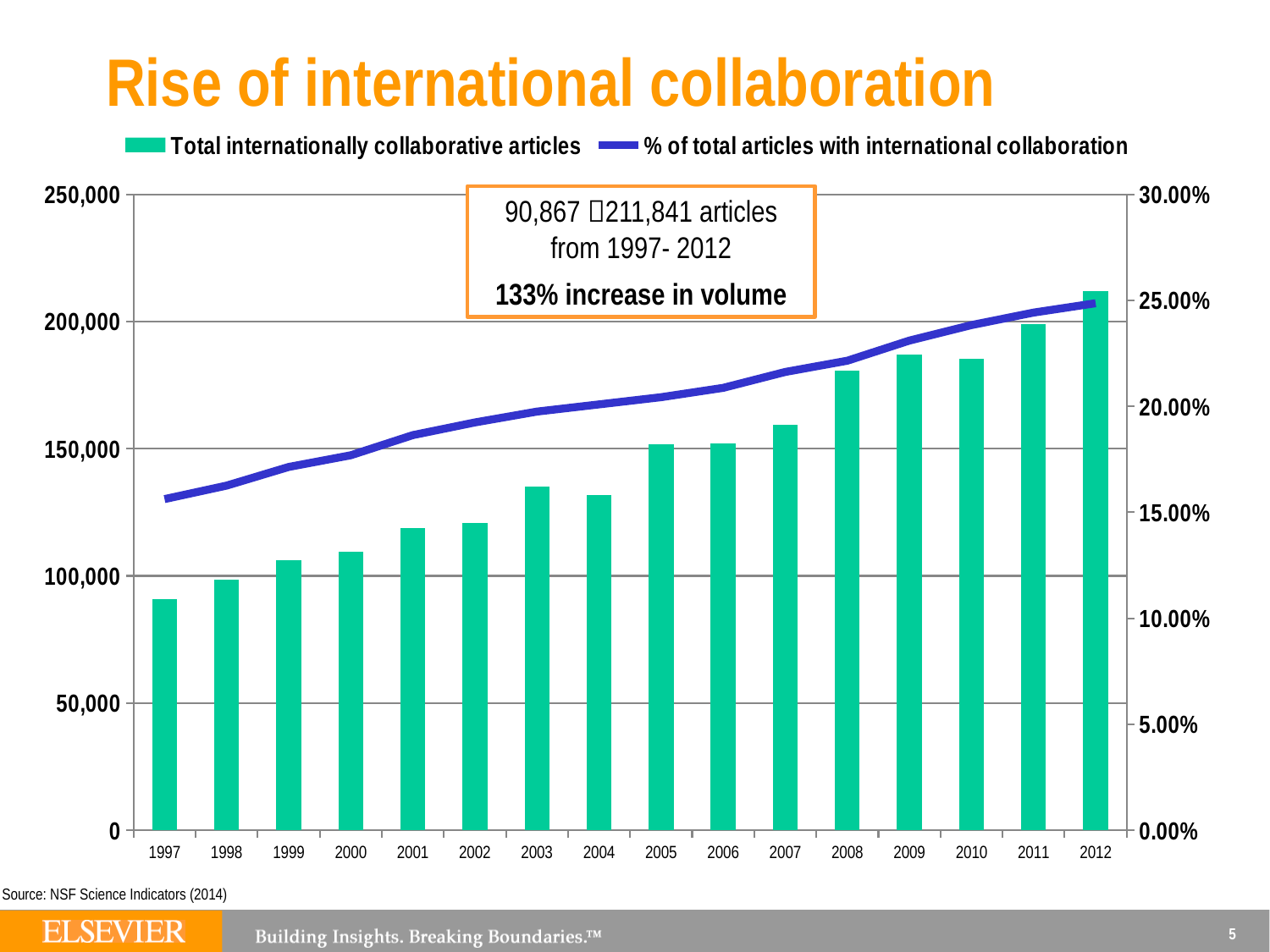
Is the number of internationally collaborative articles in 2004 greater or less than 150,000? less Which year has the lowest number of internationally collaborative articles? 1997 Is the % of total articles with international collaboration in 2007 greater or less than 20.00%? greater How many years are shown on the x axis of the chart? 16 How many series does the chart legend list? 2 Which year has more internationally collaborative articles, 2005 or 2008? 2008 What was the number of internationally collaborative articles in 1997? 90,867 Is the number of internationally collaborative articles in 2008 greater or less than 150,000? greater By how much did the number of internationally collaborative articles increase from 1997 to 2012? 120,974 What was the number of internationally collaborative articles in 2012? 211,841 Which year has the highest number of internationally collaborative articles? 2012 What percentage increase in volume of internationally collaborative articles does the slide report for 1997-2012? 133%